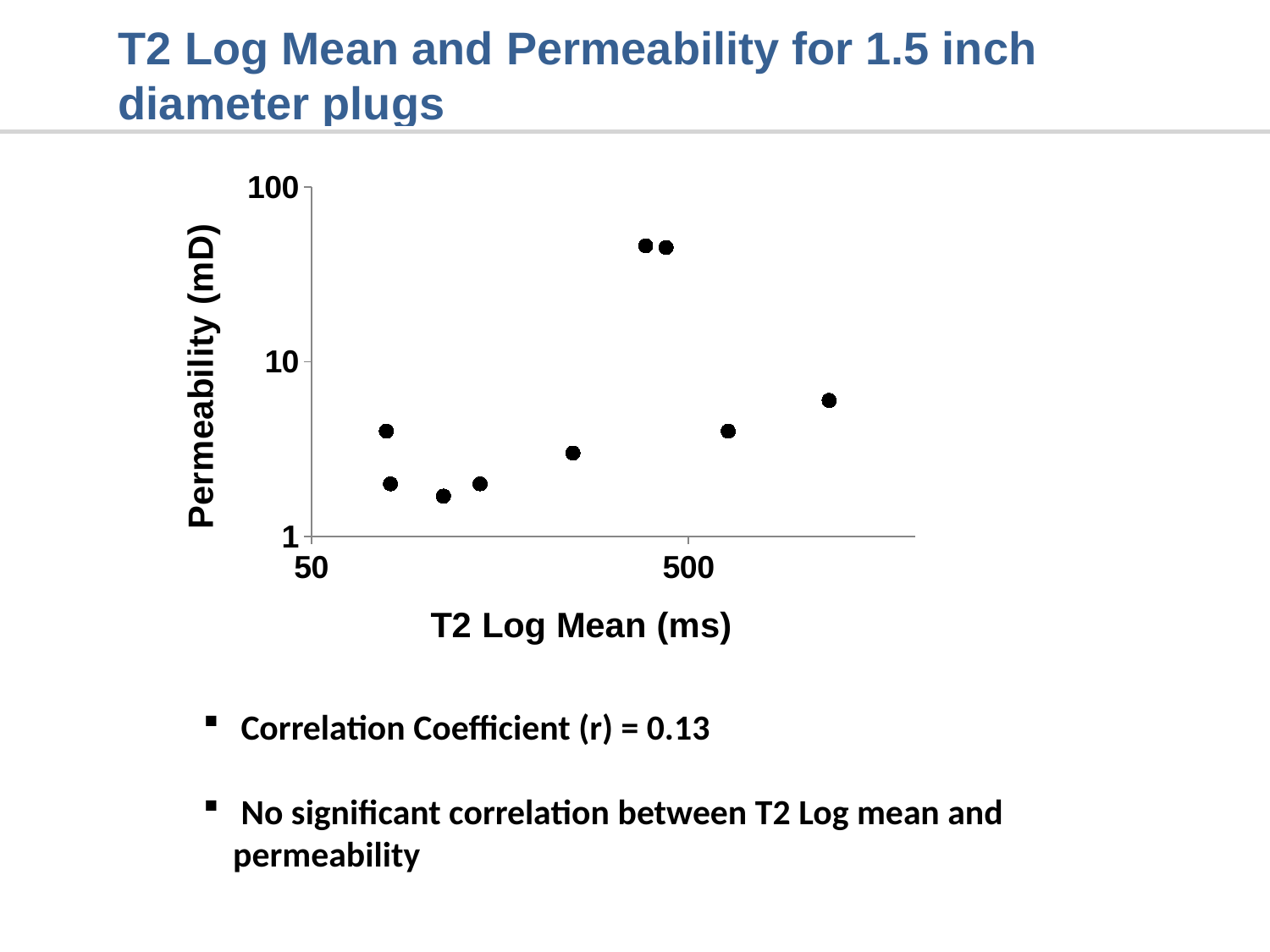
How many data points are plotted on the chart? 9 How many data points have a T2 Log Mean greater than 500 ms? 2 Is the T2 Log Mean of the two highest-permeability points greater or less than 500? less Is the permeability of the point with the highest T2 Log Mean greater or less than 10? less What is the label of the y axis? Permeability (mD) What is the label of the x axis? T2 Log Mean (ms) Is the T2 Log Mean of the leftmost point greater or less than 50? greater What kind of chart is shown on the slide? scatter plot How many data points have a permeability greater than 10 mD? 2